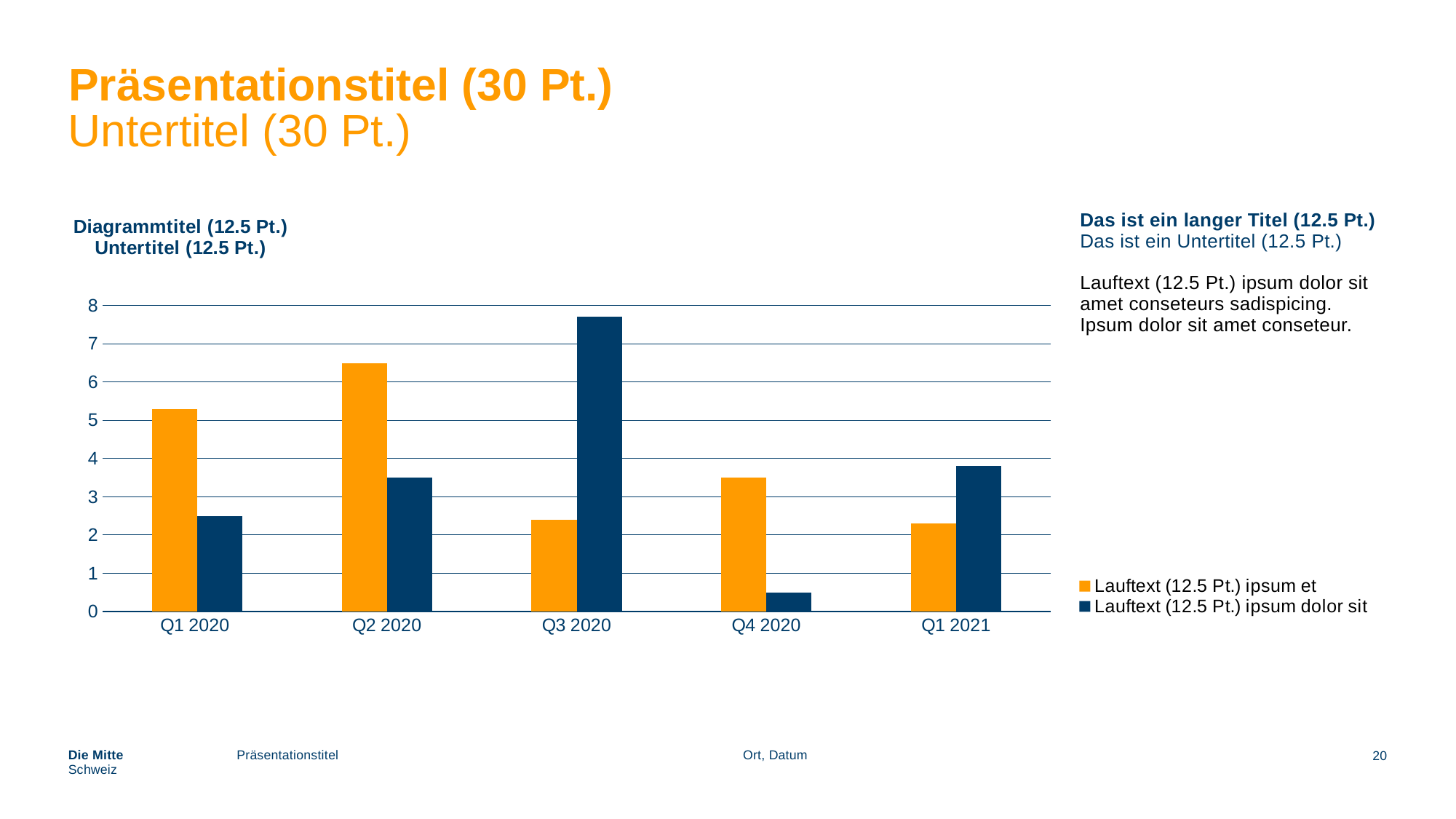
How many categories are shown on the x axis of the chart? 5 Is the value for "Lauftext (12.5 Pt.) ipsum dolor sit" in Q4 2020 greater or less than 1? less Is the value for "Lauftext (12.5 Pt.) ipsum et" in Q2 2020 greater or less than 6? greater How many series does the chart's legend list? 2 What kind of chart is shown on the slide? bar chart Which category has the highest value for the series "Lauftext (12.5 Pt.) ipsum dolor sit"? Q3 2020 In Q3 2020, which series has the larger value: "Lauftext (12.5 Pt.) ipsum et" or "Lauftext (12.5 Pt.) ipsum dolor sit"? Lauftext (12.5 Pt.) ipsum dolor sit Which category has the lowest value for the series "Lauftext (12.5 Pt.) ipsum dolor sit"? Q4 2020 In Q1 2020, which series has the larger value: "Lauftext (12.5 Pt.) ipsum et" or "Lauftext (12.5 Pt.) ipsum dolor sit"? Lauftext (12.5 Pt.) ipsum et Which category has the highest value for the series "Lauftext (12.5 Pt.) ipsum et"? Q2 2020 Is the value for "Lauftext (12.5 Pt.) ipsum dolor sit" in Q3 2020 greater or less than 7? greater What colour are the bars for the series "Lauftext (12.5 Pt.) ipsum et"? orange